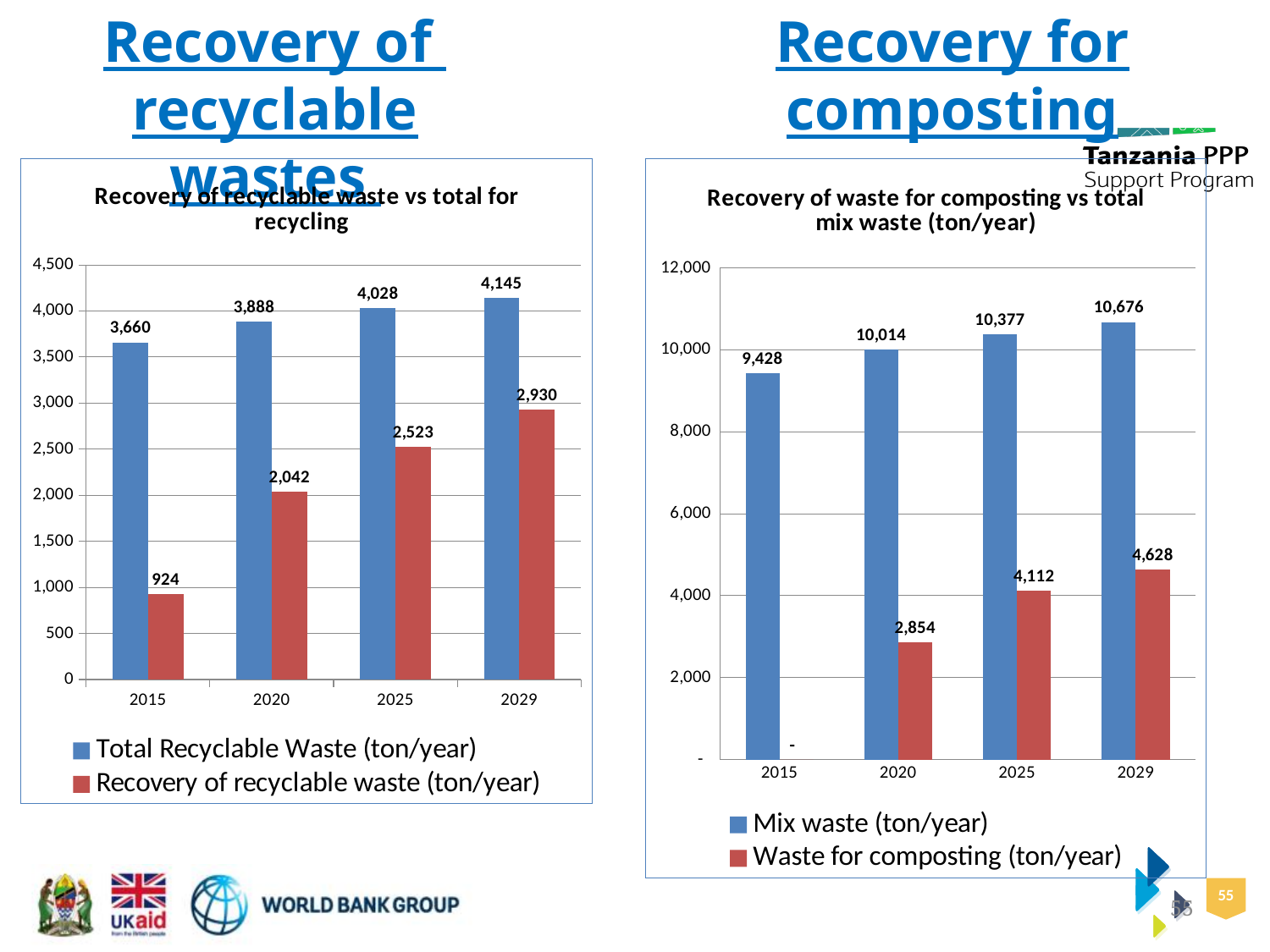
What kind of chart is the 'Recovery of waste for composting vs total mix waste (ton/year)' chart? bar chart In the 'Recovery of recyclable waste vs total for recycling' chart, what is the Recovery of recyclable waste value for 2020? 2,042 In the 'Recovery of waste for composting vs total mix waste (ton/year)' chart, what is the Mix waste value for 2025? 10,377 In the 'Recovery of recyclable waste vs total for recycling' chart, what is the difference between Total Recyclable Waste and Recovery of recyclable waste in 2029? 1,215 In the 'Recovery of recyclable waste vs total for recycling' chart, does the Total Recyclable Waste value rise or fall from 2015 to 2029? rise In the 'Recovery of waste for composting vs total mix waste (ton/year)' chart, what is the difference in Waste for composting between 2025 and 2020? 1,258 In the 'Recovery of recyclable waste vs total for recycling' chart, what is the Total Recyclable Waste value for 2015? 3,660 In the 'Recovery of waste for composting vs total mix waste (ton/year)' chart, which year has the highest Mix waste value? 2029 In the 'Recovery of waste for composting vs total mix waste (ton/year)' chart, what is the Waste for composting value for 2029? 4,628 In the 'Recovery of recyclable waste vs total for recycling' chart, how many series does the legend list? 2 In the 'Recovery of waste for composting vs total mix waste (ton/year)' chart, how many years are shown on the x axis? 4 In the 'Recovery of recyclable waste vs total for recycling' chart, which year has the lowest Recovery of recyclable waste value? 2015